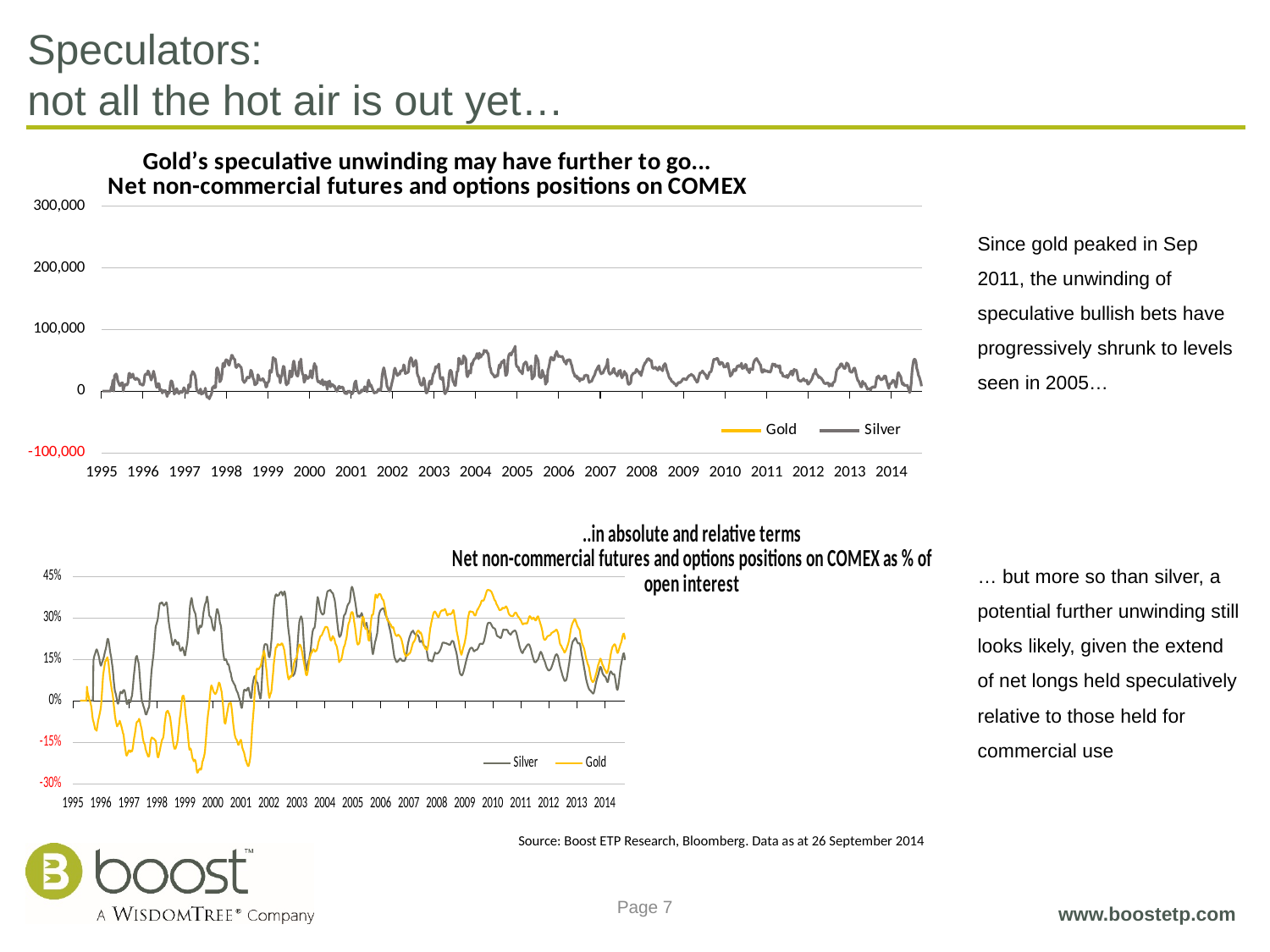
In the bottom chart, is the Gold value around 1999 greater or less than -15%? less How many series does the legend of the top chart list? 2 What is the first year shown on the x-axis of the top chart? 1995 Which two series are listed in the legend of the bottom chart? Silver and Gold How many year labels appear on the x-axis of the bottom chart? 20 In the bottom chart, is the Silver value around 2005 greater or less than 30%? greater In the bottom chart, is the Gold value around 2010 greater or less than 30%? greater What kind of chart is the bottom chart showing positions as % of open interest? Line chart What kind of chart is the top chart titled "Net non-commercial futures and options positions on COMEX"? Line chart What is the highest value shown on the y-axis of the top chart? 300,000